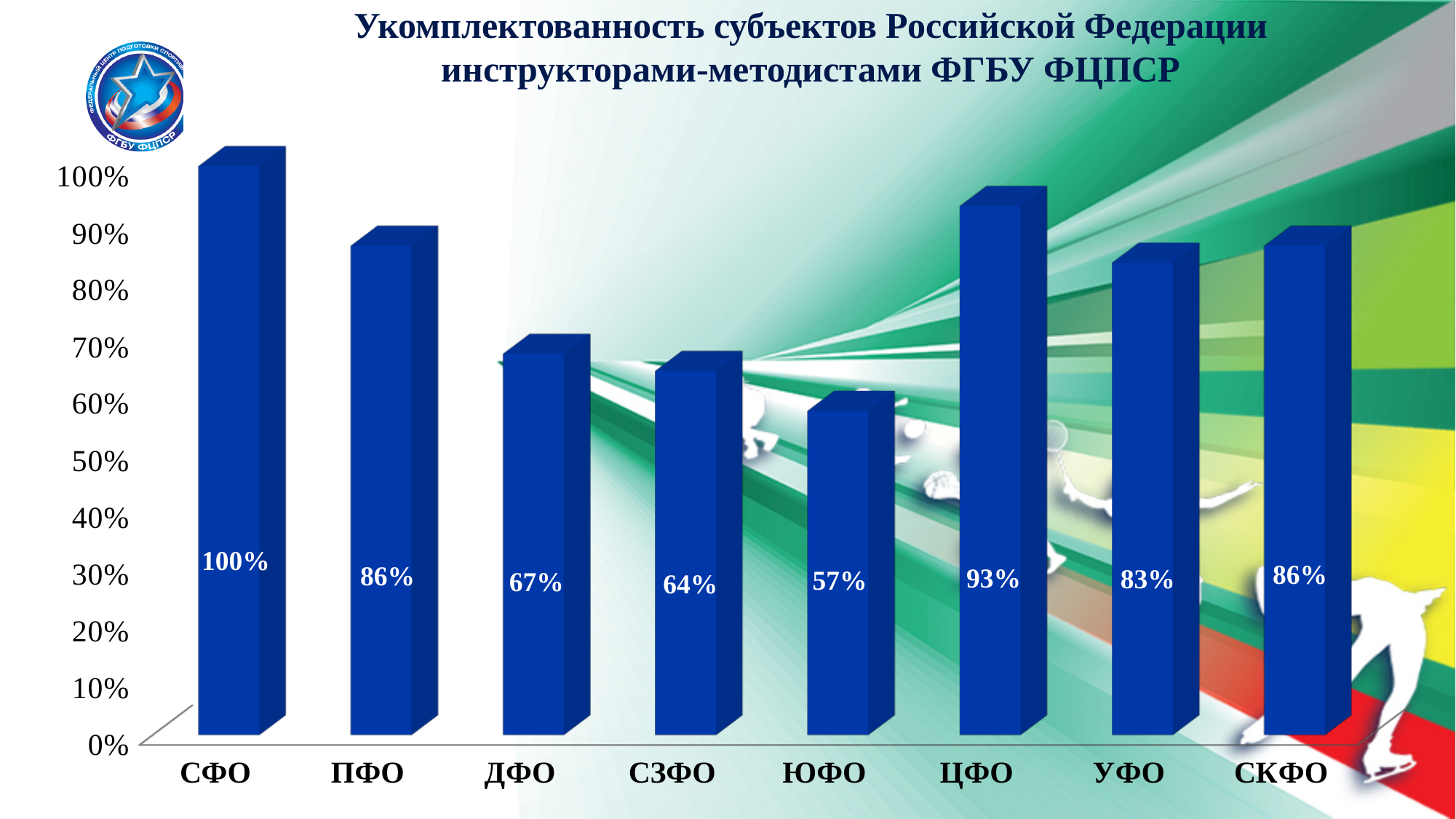
Which category has the highest value? СФО Which is larger, the value for ДФО or the value for СЗФО? ДФО What is the difference between the values for СФО and ЮФО? 43% How many categories are shown on the x axis? 8 Which category has the lowest value? ЮФО What is the value for ЦФО? 93% What kind of chart is shown on the slide? bar chart What is the difference between the values for ЦФО and УФО? 10% What is the value for СФО? 100% What is the title of the chart? Укомплектованность субъектов Российской Федерации инструкторами-методистами ФГБУ ФЦПСР What is the value for УФО? 83% What is the value for ЮФО? 57%